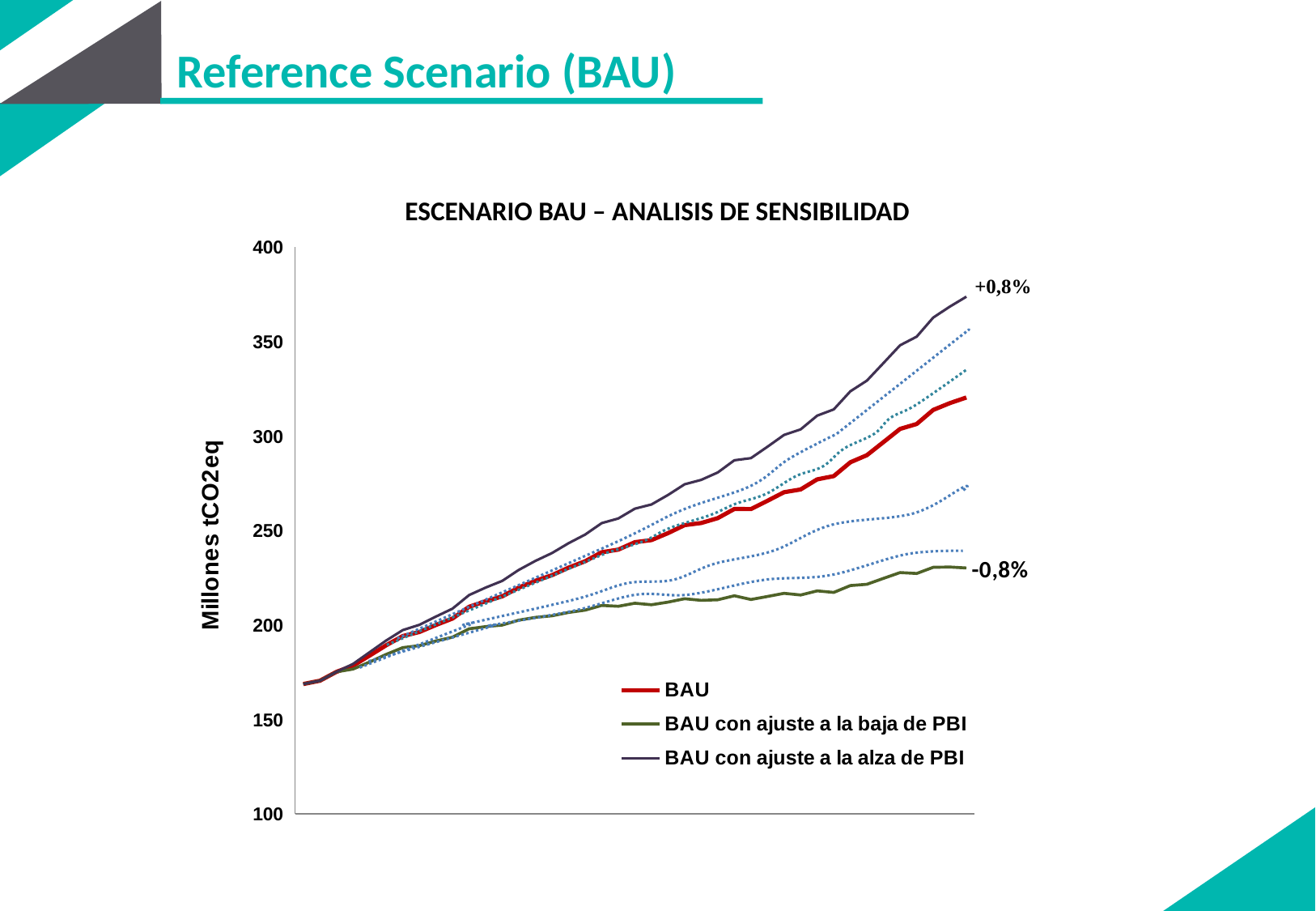
At the right end of the chart, which is higher: the BAU series or the BAU con ajuste a la baja de PBI series? BAU What is the title of the chart? ESCENARIO BAU – ANALISIS DE SENSIBILIDAD Which series has the lowest value at the right end of the chart? BAU con ajuste a la baja de PBI How many series does the chart legend list? 3 Does the BAU series rise or fall from left to right along the x axis? Rise Is the final value of the BAU series greater or less than 300? greater What is the label on the vertical axis of the chart? Millones tCO2eq Is the final value of the BAU con ajuste a la baja de PBI series greater or less than 250? less Is the starting value of the BAU series at the left of the chart greater or less than 200? less Which series reaches the highest value at the right end of the chart? BAU con ajuste a la alza de PBI What kind of chart is shown on the slide? Line chart